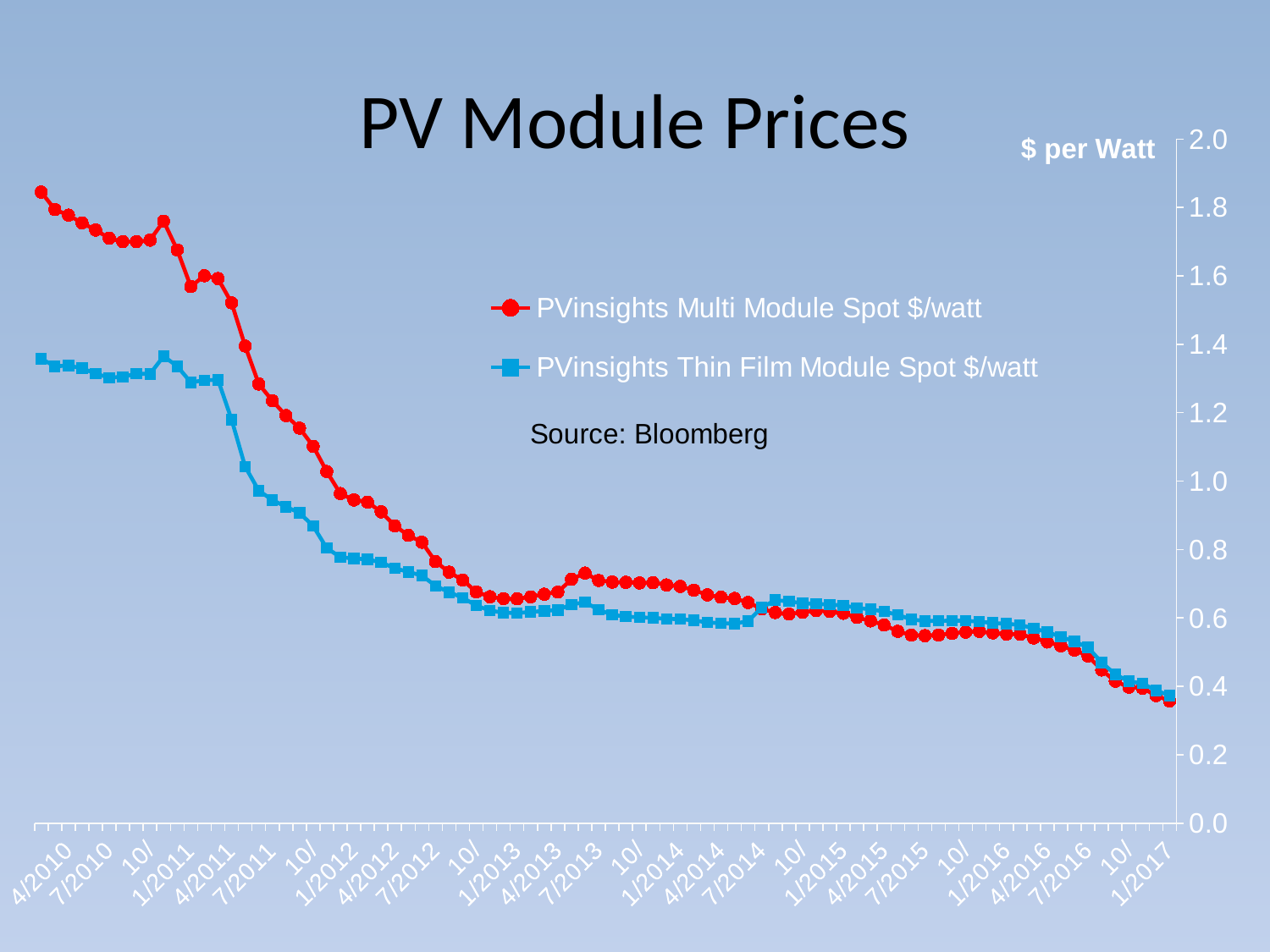
Is the PVinsights Multi Module Spot $/watt value at 4/2010 greater or less than 1.6? greater Is the PVinsights Multi Module Spot $/watt value at 1/2017 greater or less than 0.4? less How many series does the legend list? 2 At 7/2011, which series has the higher value: PVinsights Multi Module Spot $/watt or PVinsights Thin Film Module Spot $/watt? PVinsights Multi Module Spot $/watt Do the PVinsights Thin Film Module Spot $/watt values generally rise or fall over the period shown? Fall What source is cited for the chart data? Bloomberg What is the title of the chart? PV Module Prices At 4/2010, which series has the higher value: PVinsights Multi Module Spot $/watt or PVinsights Thin Film Module Spot $/watt? PVinsights Multi Module Spot $/watt Is the PVinsights Thin Film Module Spot $/watt value at 4/2010 greater or less than 1.2? greater What kind of chart is shown on the slide? Line chart Do the PVinsights Multi Module Spot $/watt values generally rise or fall from 4/2010 to 1/2017? Fall